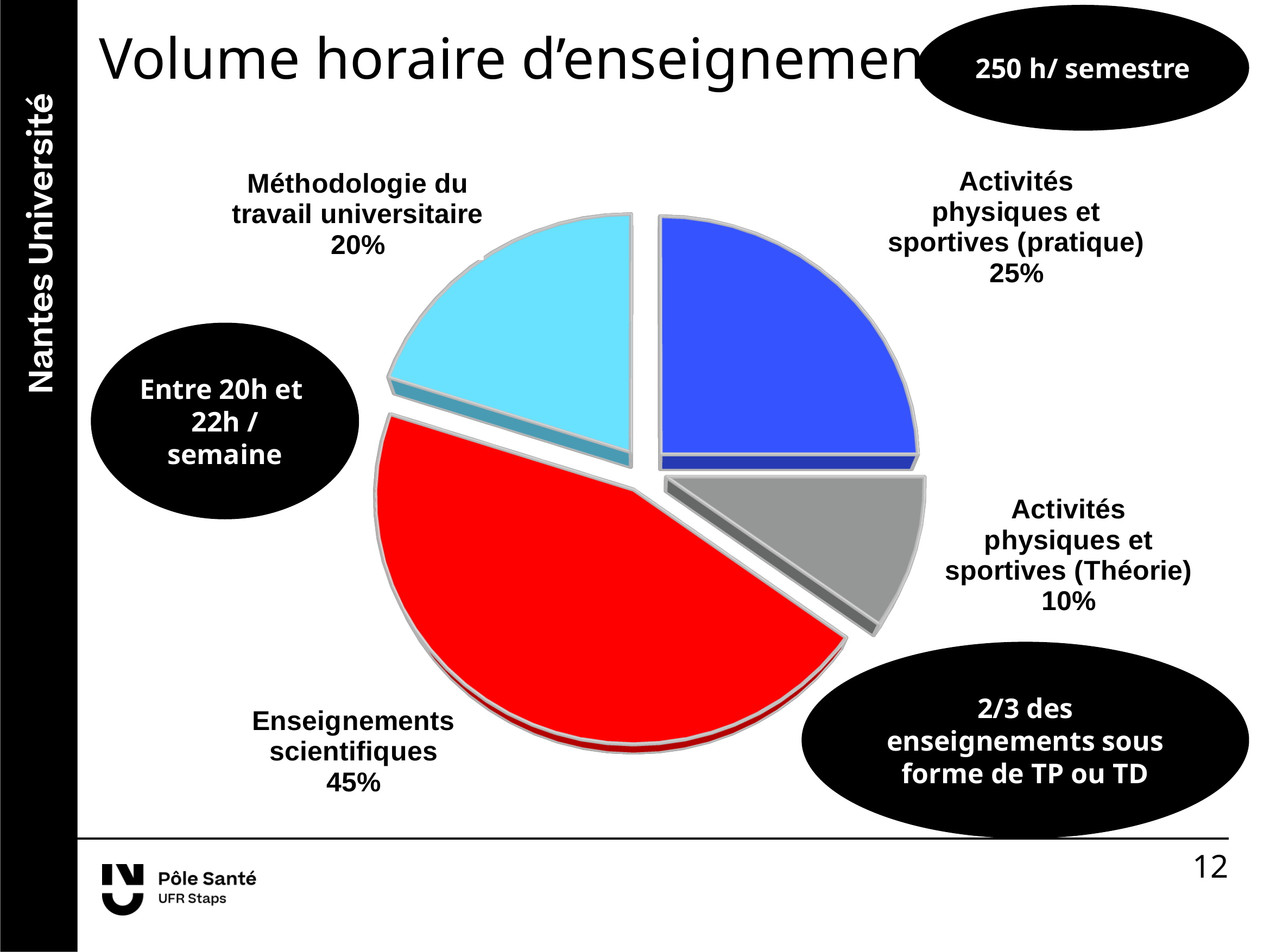
What kind of chart is shown on the slide? pie chart What colour is the Activités physiques et sportives (Théorie) slice? grey What colour is the Enseignements scientifiques slice? red How many slices does the pie chart have? 4 What share of the pie is Activités physiques et sportives (Théorie)? 10% Which is larger, Méthodologie du travail universitaire or Activités physiques et sportives (Théorie)? Méthodologie du travail universitaire Which slice of the pie is the largest? Enseignements scientifiques What is the difference in percentage points between Enseignements scientifiques and Activités physiques et sportives (pratique)? 20 What share of the pie is Méthodologie du travail universitaire? 20% Which slice of the pie is the smallest? Activités physiques et sportives (Théorie) What share of the pie is Activités physiques et sportives (pratique)? 25%